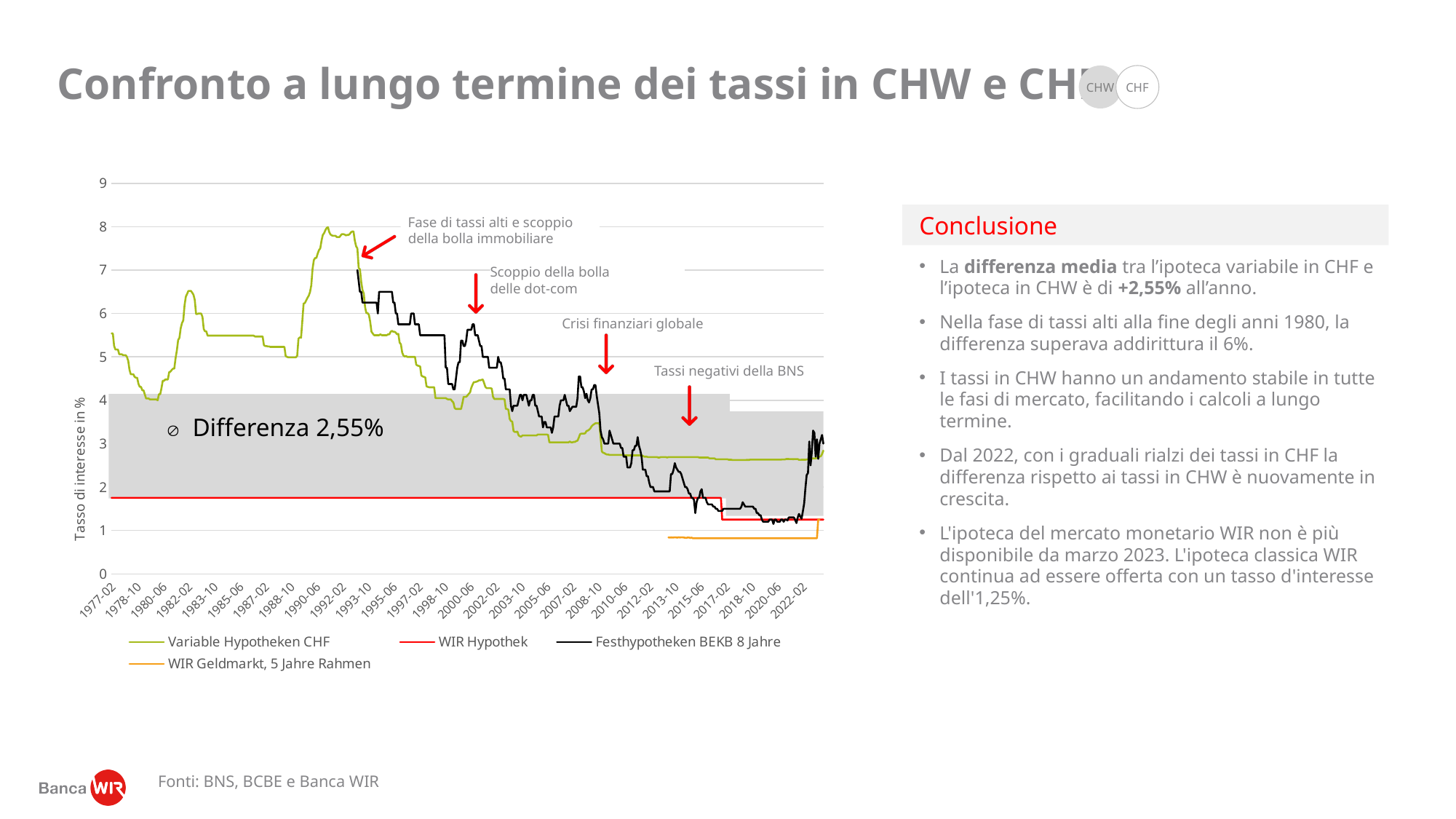
Is the peak value of Variable Hypotheken CHF around 1991 greater or less than 7? greater What is the title of the vertical axis of the chart? Tasso di interesse in % Is the value of WIR Hypothek before 2017 greater or less than 2? less Is the value of Festhypotheken BEKB 8 Jahre around 2020 greater or less than 2? less Does the Variable Hypotheken CHF line rise or fall between 1992 and 2020? fall What average difference is annotated inside the shaded area of the chart? 2,55% Which series has the lowest values on the chart? WIR Geldmarkt, 5 Jahre Rahmen How many series does the chart legend list? 4 Around 2010, which is higher: Variable Hypotheken CHF or WIR Hypothek? Variable Hypotheken CHF What kind of chart is shown on the slide? line chart Which series reaches the highest value on the chart? Variable Hypotheken CHF